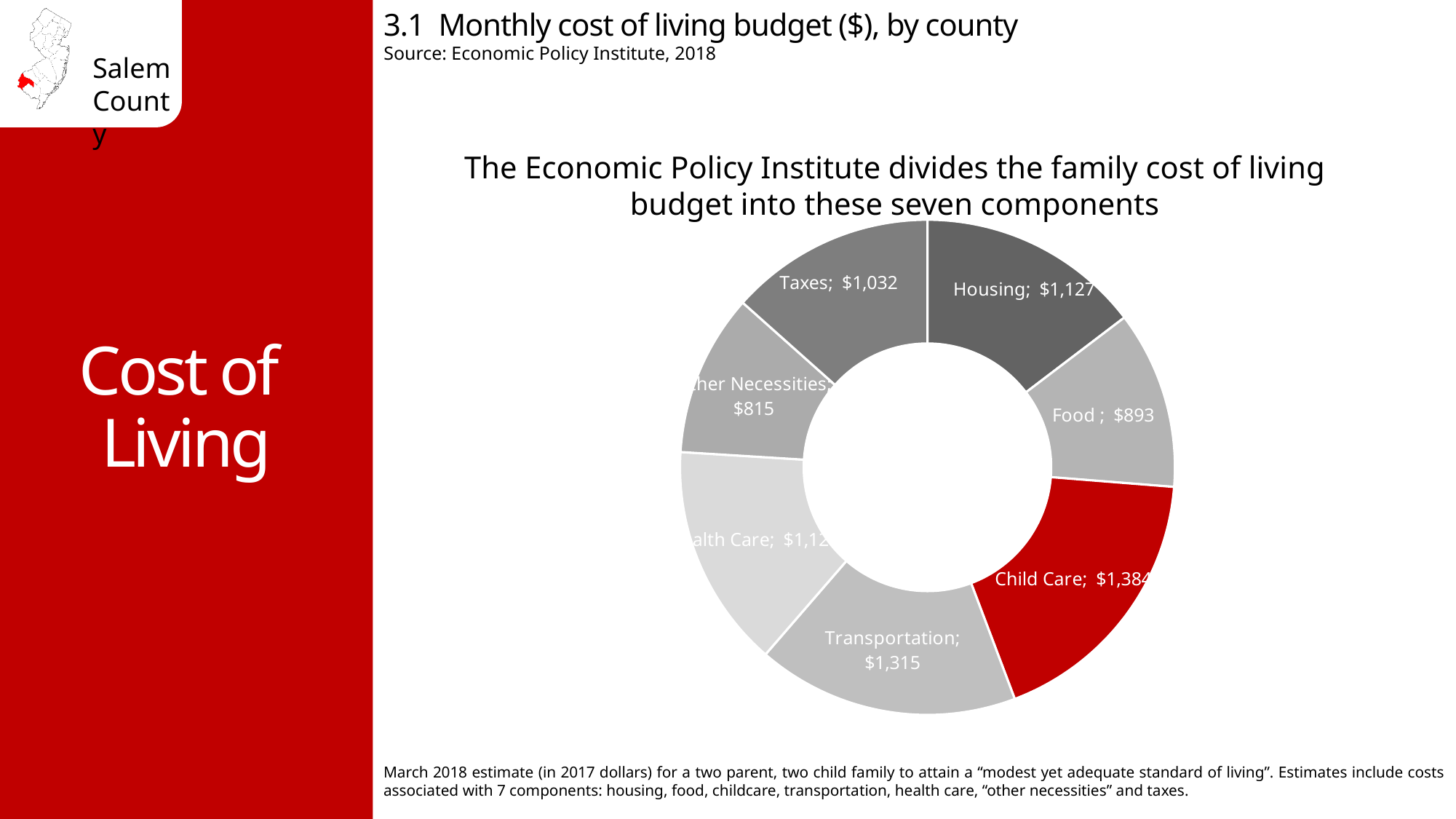
How many components are shown in the chart? 7 What is the monthly cost for Taxes? $1,032 What is the monthly cost for Child Care? $1,384 Which component has the lowest monthly cost? Other Necessities What is the monthly cost for Food? $893 What is the monthly cost for Transportation? $1,315 What is the monthly cost for Other Necessities? $815 Which is larger, the monthly cost for Housing or for Taxes? Housing How much more is the monthly cost for Child Care than for Transportation? $69 Which component has the highest monthly cost? Child Care What is the monthly cost for Housing? $1,127 What kind of chart is shown on the slide? doughnut chart